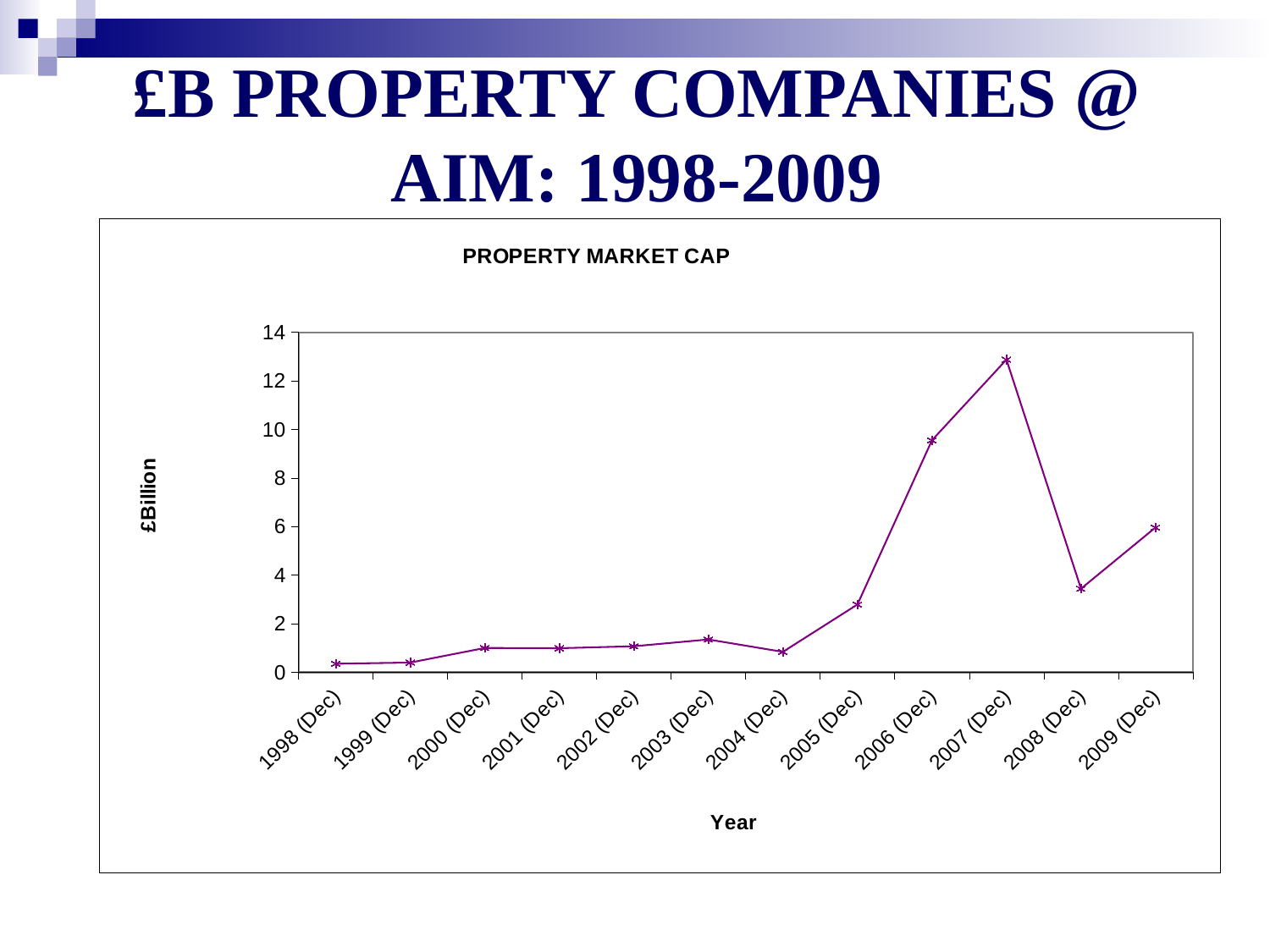
Is the value for 2005 (Dec) greater or less than 2? greater How many data points are plotted on the chart? 12 Does the property market cap rise or fall from 2007 (Dec) to 2008 (Dec)? fall Which is larger, the value for 2006 (Dec) or the value for 2009 (Dec)? 2006 (Dec) Is the value for 2007 (Dec) greater or less than 12? greater Is the value for 2008 (Dec) greater or less than 4? less What is the label on the vertical axis of the chart? £Billion What is the title of the chart? PROPERTY MARKET CAP What kind of chart is shown on the slide? line chart Which year has the highest property market cap? 2007 (Dec)